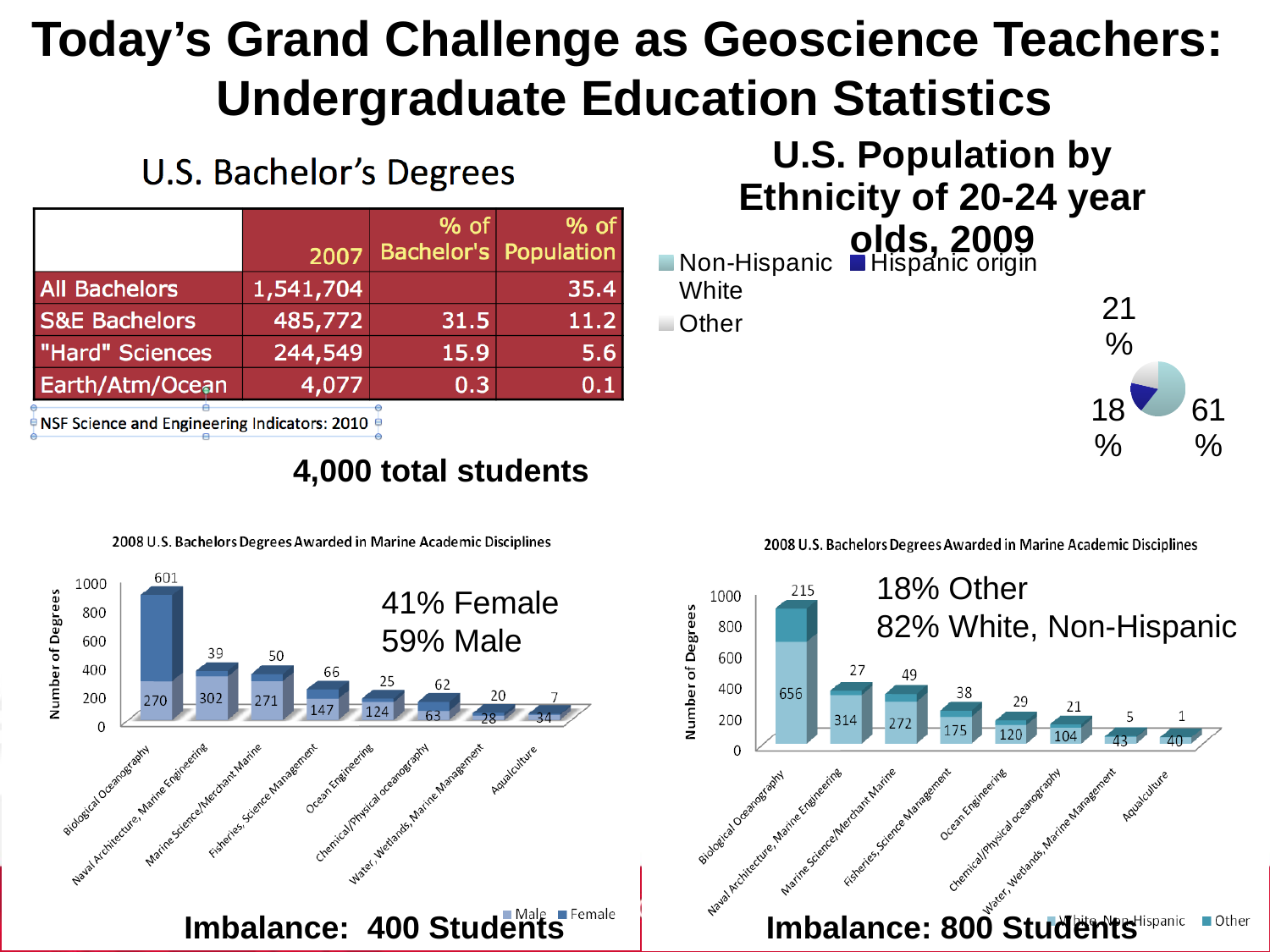
In the pie chart 'U.S. Population by Ethnicity of 20-24 year olds, 2009', what share is Non-Hispanic White? 61% In the bottom-left bar chart (Male/Female), what is the Male value for Naval Architecture, Marine Engineering? 302 In the bottom-right bar chart (White, Non-Hispanic/Other), what is the White, Non-Hispanic value for Biological Oceanography? 656 What kind of chart is the bottom-left chart '2008 U.S. Bachelors Degrees Awarded in Marine Academic Disciplines'? Bar chart In the bottom-right bar chart (White, Non-Hispanic/Other), what is the difference between the White, Non-Hispanic and Other values for Naval Architecture, Marine Engineering? 287 In the bottom-right bar chart (White, Non-Hispanic/Other), which discipline has the highest Other value? Biological Oceanography In the bottom-left bar chart (Male/Female), what is the Female value for Biological Oceanography? 601 In the bottom-left bar chart (Male/Female), what is the total of the stacked bar for Biological Oceanography? 871 How many categories does the legend of the pie chart 'U.S. Population by Ethnicity of 20-24 year olds, 2009' list? 3 In the bottom-left bar chart (Male/Female), which discipline has the lowest Female value? Aquaculture In the pie chart 'U.S. Population by Ethnicity of 20-24 year olds, 2009', what share is Hispanic origin? 18% In the bottom-left bar chart (Male/Female), how many disciplines are shown on the x axis? 8